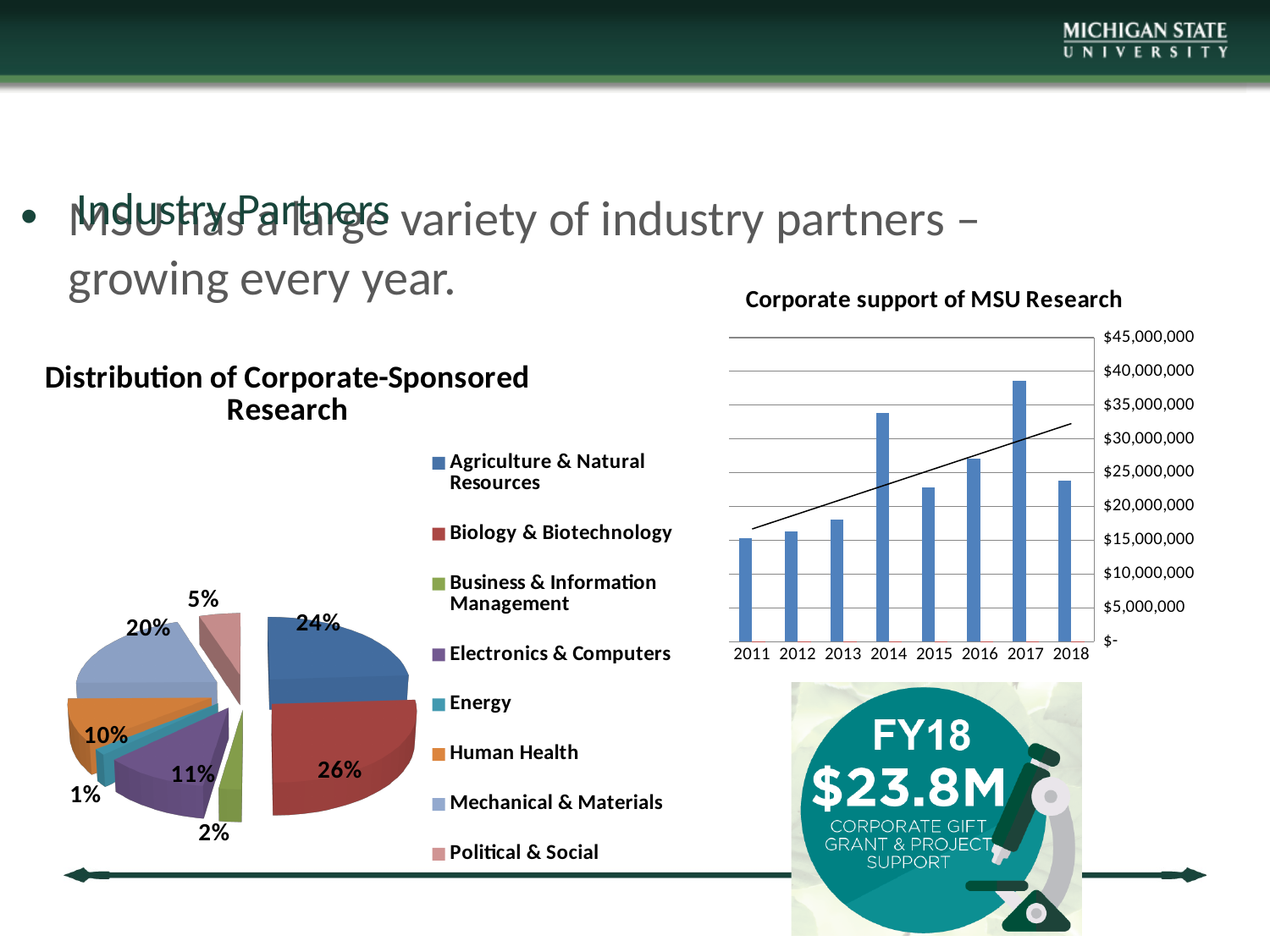
In the Distribution of Corporate-Sponsored Research pie chart, what share does Mechanical & Materials have? 20% What kind of chart is the Distribution of Corporate-Sponsored Research chart? Pie chart In the Corporate support of MSU Research chart, which year has the lowest value? 2011 In the Distribution of Corporate-Sponsored Research pie chart, what is the difference between the shares of Agriculture & Natural Resources and Human Health? 14% In the Corporate support of MSU Research chart, is the value for 2014 greater or less than $30,000,000? greater In the Distribution of Corporate-Sponsored Research pie chart, what share does Biology & Biotechnology have? 26% How many years does the Corporate support of MSU Research bar chart show? 8 In the Distribution of Corporate-Sponsored Research pie chart, which has a larger share, Electronics & Computers or Political & Social? Electronics & Computers How many categories does the Distribution of Corporate-Sponsored Research pie chart show? 8 In the Distribution of Corporate-Sponsored Research pie chart, which category has the smallest share? Energy In the Corporate support of MSU Research chart, which year has the highest value? 2017 In the Distribution of Corporate-Sponsored Research pie chart, which category has the largest share? Biology & Biotechnology